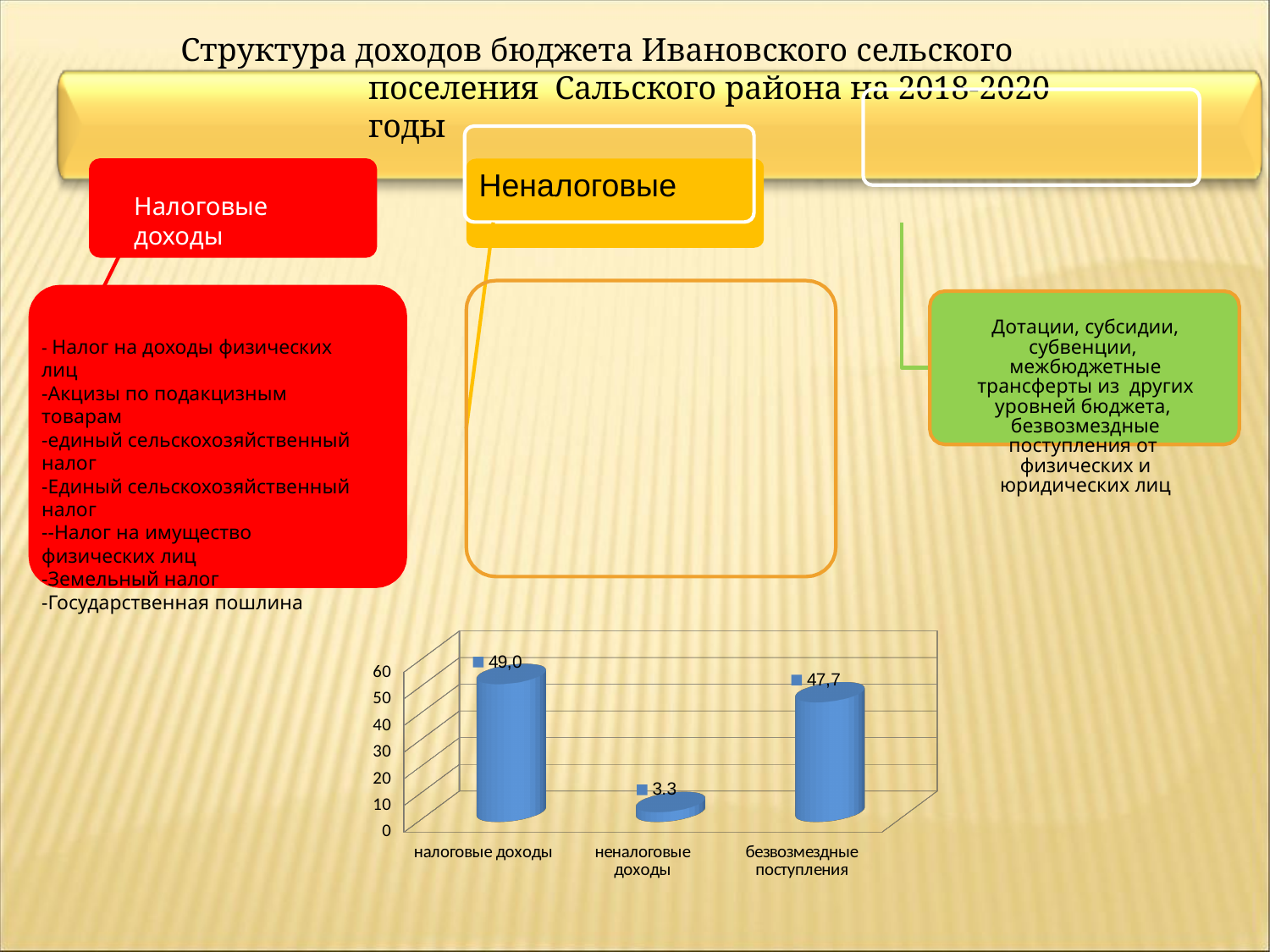
What is the value for безвозмездные поступления? 47,7 What is the difference between the values for налоговые доходы and безвозмездные поступления? 1,3 What is the difference between the values for налоговые доходы and неналоговые доходы? 45,7 What is the value for неналоговые доходы? 3,3 What kind of chart is shown on the slide? bar chart Which category has the lowest value? неналоговые доходы How many categories are shown on the chart? 3 Which is larger, the value for неналоговые доходы or the value for безвозмездные поступления? безвозмездные поступления What is the value for налоговые доходы? 49,0 Is the value for безвозмездные поступления greater or less than 40? greater Is the value for неналоговые доходы greater or less than 10? less Which category has the highest value? налоговые доходы